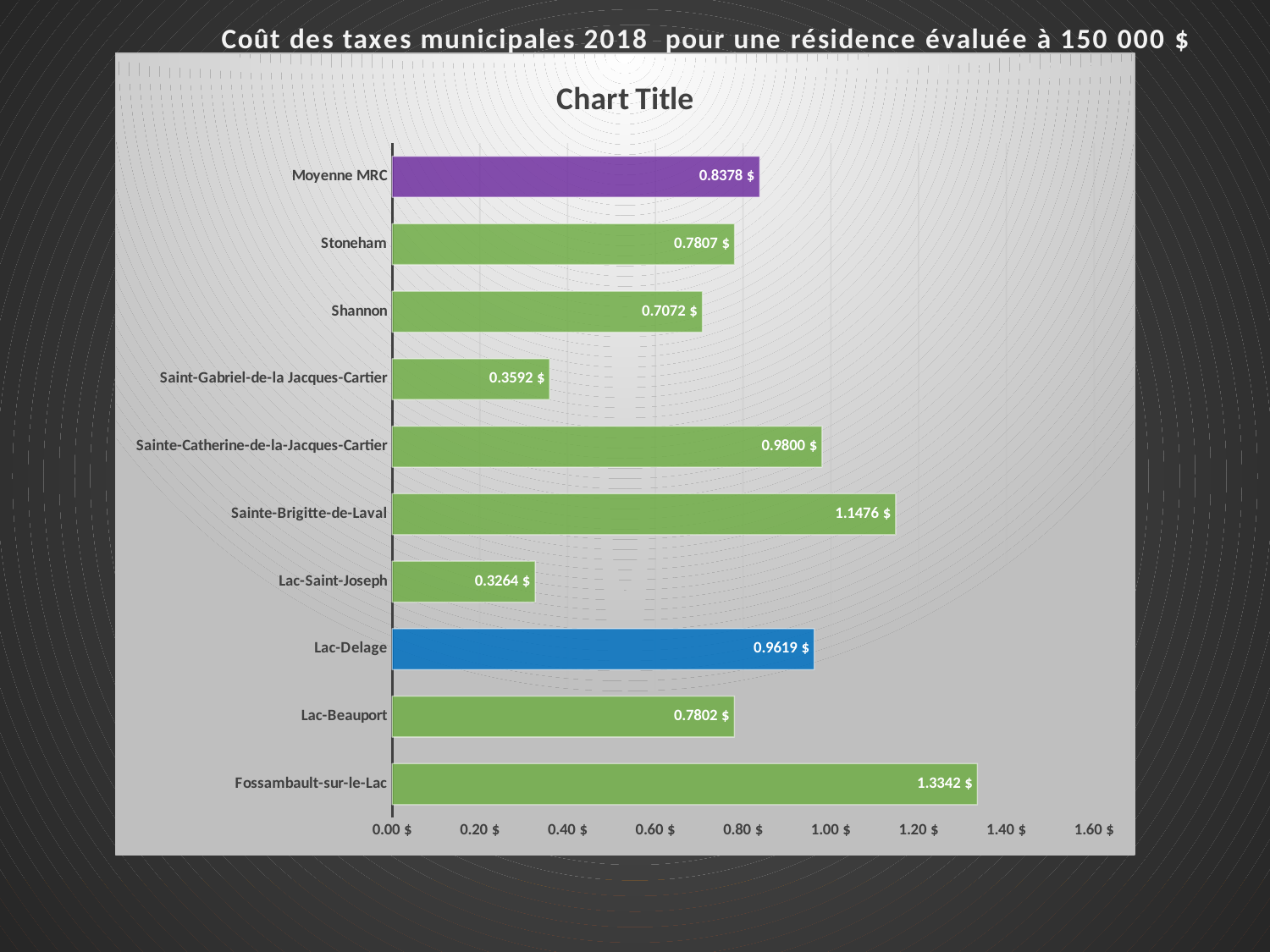
What is the value for Lac-Delage? 0.9619 $ What is the value for Moyenne MRC? 0.8378 $ Which municipality has the lowest value? Lac-Saint-Joseph Which municipality has the highest value? Fossambault-sur-le-Lac How many categories are shown in the chart? 10 What is the value for Fossambault-sur-le-Lac? 1.3342 $ Which is larger, the value for Sainte-Brigitte-de-Laval or the value for Sainte-Catherine-de-la-Jacques-Cartier? Sainte-Brigitte-de-Laval What is the difference between the values for Sainte-Brigitte-de-Laval and Moyenne MRC? 0.3098 $ What is the difference between the values for Fossambault-sur-le-Lac and Lac-Saint-Joseph? 1.0078 $ What kind of chart is shown on the slide? bar chart What is the value for Saint-Gabriel-de-la Jacques-Cartier? 0.3592 $ Is the value for Shannon greater or less than 0.80 $? less